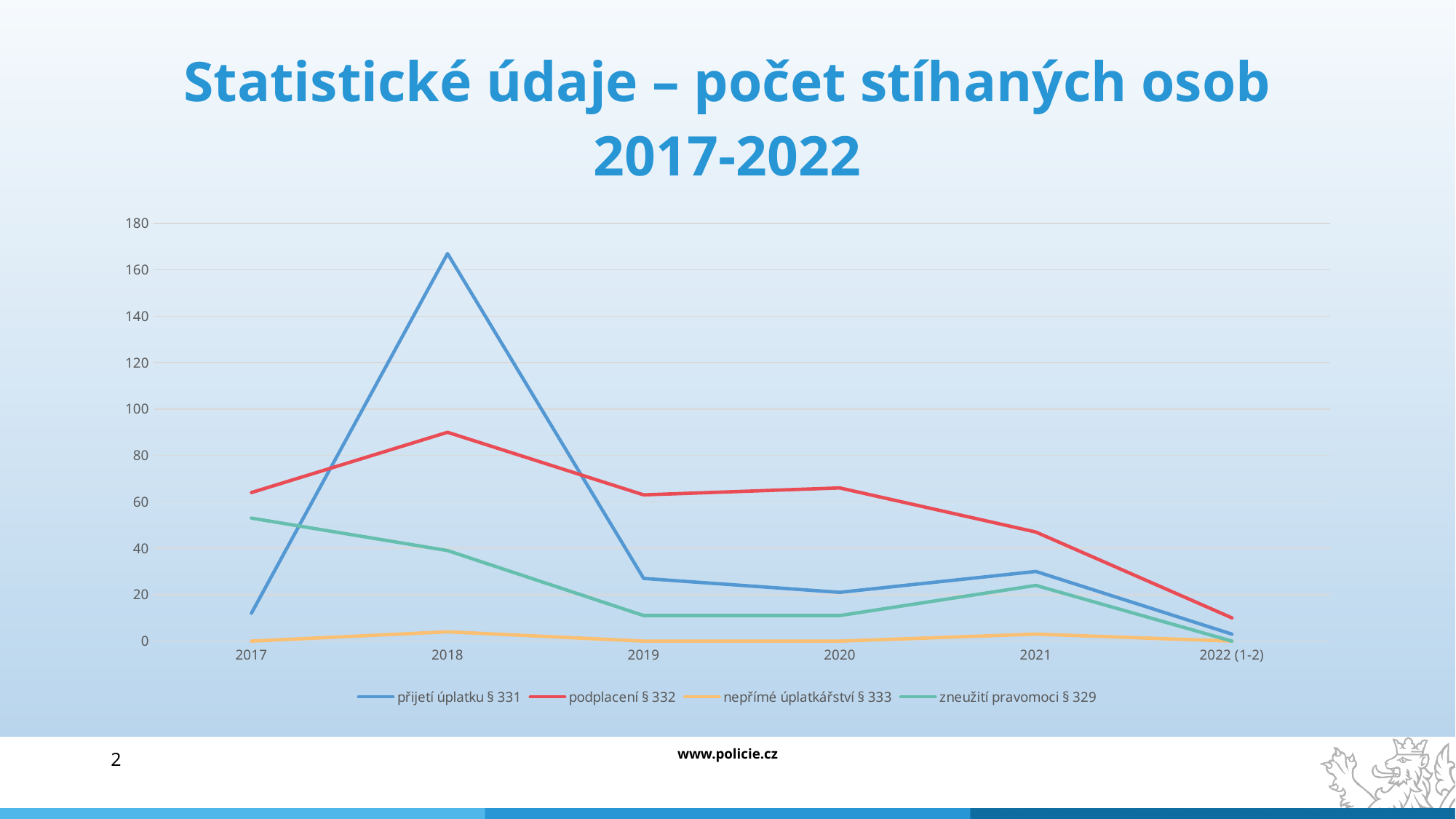
What is the title of the slide containing the chart? Statistické údaje – počet stíhaných osob 2017-2022 Which series has the lowest value in 2018? nepřímé úplatkářství § 333 What kind of chart is shown on the slide? line chart How many points are plotted along the x axis for each series? 6 In 2018, which is larger: přijetí úplatku § 331 or podplacení § 332? přijetí úplatku § 331 Is the value for zneužití pravomoci § 329 in 2017 greater or less than 40? greater How many series does the legend list? 4 Is the value for podplacení § 332 in 2018 greater or less than 80? greater In 2017, which is larger: podplacení § 332 or přijetí úplatku § 331? podplacení § 332 Does the series podplacení § 332 rise or fall from 2018 to 2022 (1-2)? fall In which year does the series přijetí úplatku § 331 reach its highest value? 2018 Is the value for přijetí úplatku § 331 in 2018 greater or less than 160? greater